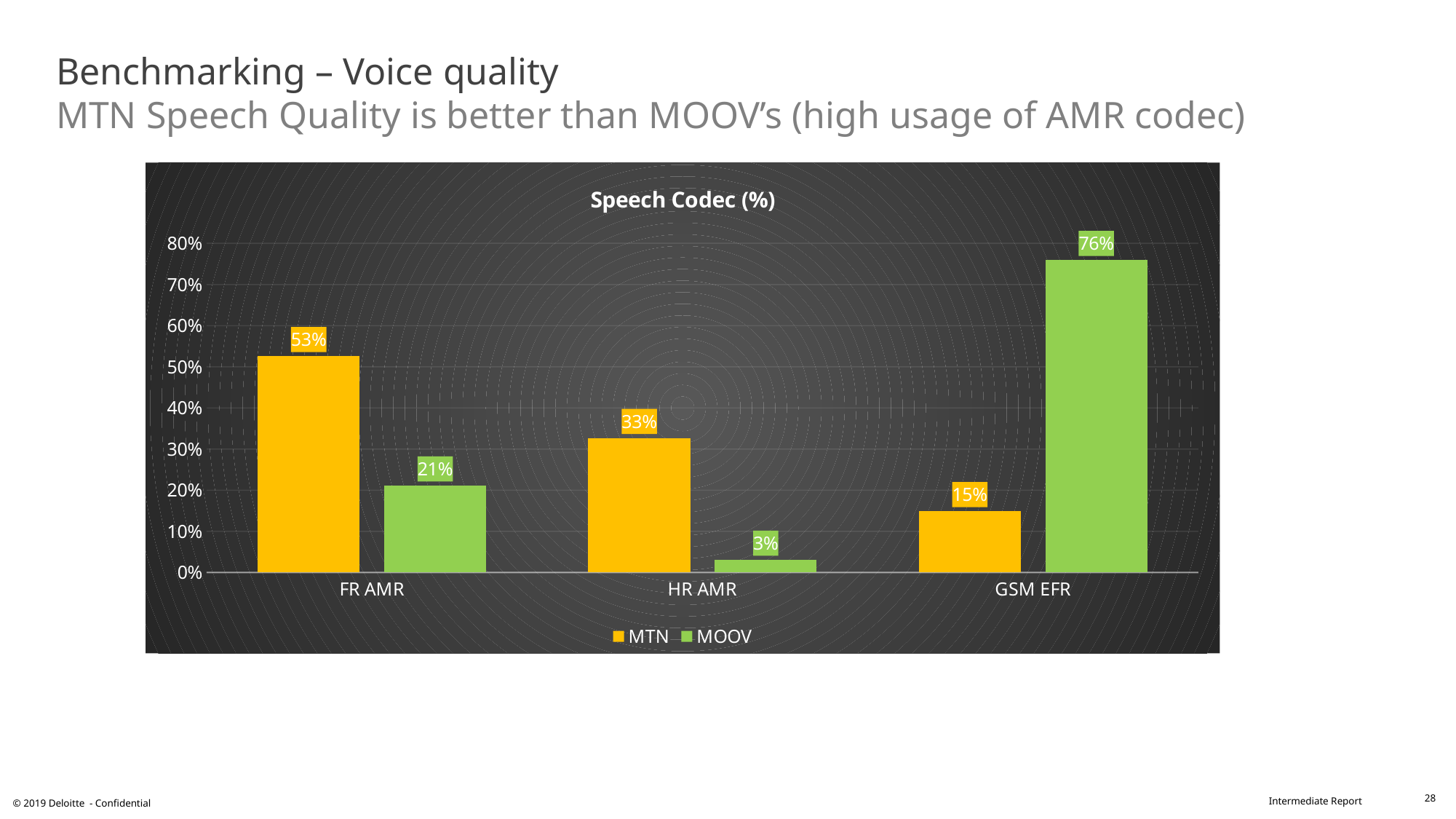
What kind of chart is shown on the slide? Bar chart What is the MOOV value for HR AMR? 3% How many codec categories are shown on the x axis? 3 Which codec has the lowest MOOV value? HR AMR How many series does the legend list? 2 What is the difference between the MTN and MOOV values for FR AMR? 32% Which codec has the highest MTN value? FR AMR What is the MTN value for FR AMR? 53% Which is larger for HR AMR, the MTN value or the MOOV value? MTN What is the MTN value for GSM EFR? 15% What is the title of the chart? Speech Codec (%) What is the MOOV value for GSM EFR? 76%